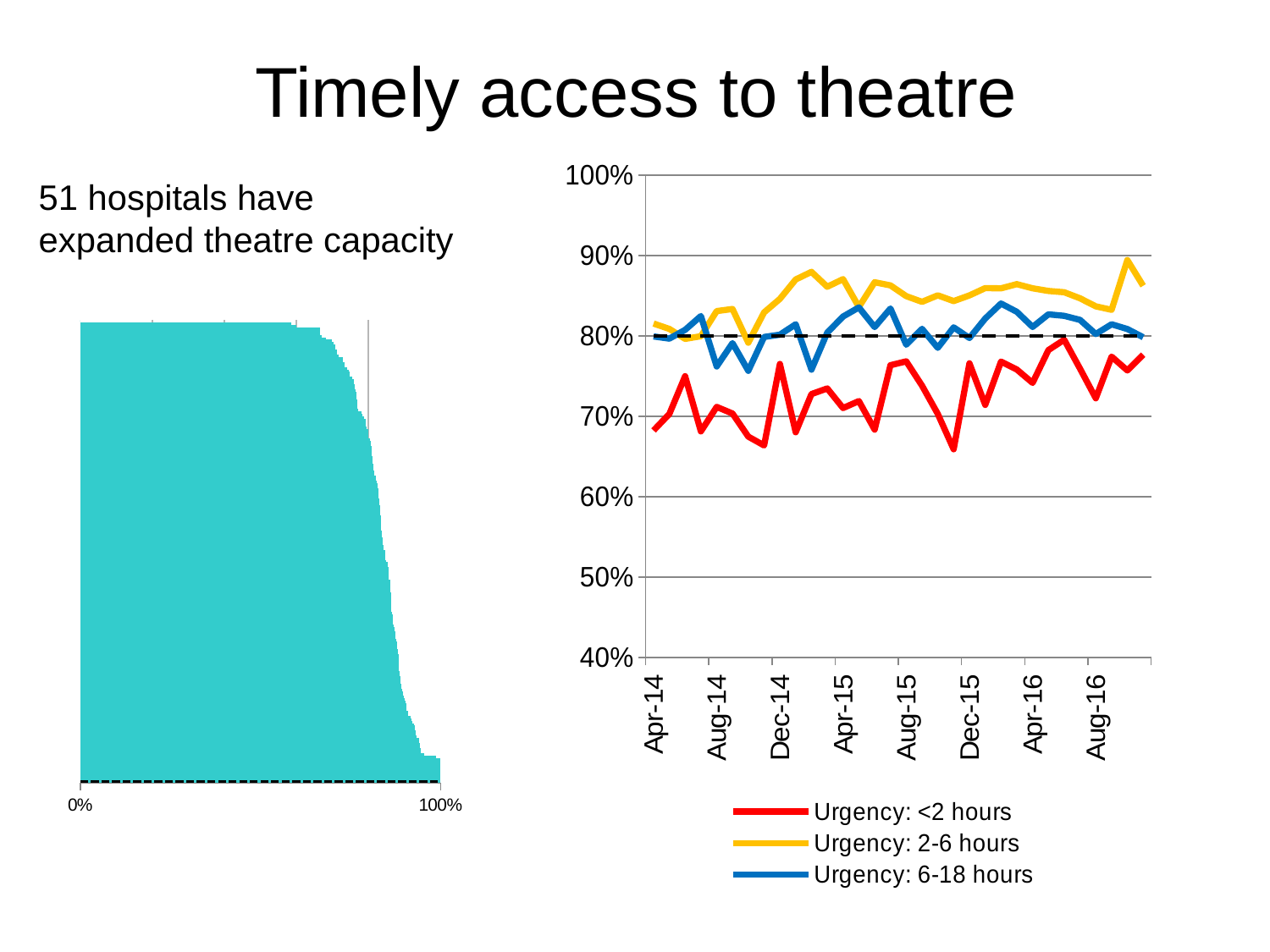
On the right-hand chart, is the value for Urgency: 6-18 hours at Apr-15 greater or less than 70%? greater On the right-hand chart, how many series does the legend list? 3 On the right-hand chart, what is the lowest value shown on the y axis? 40% On the right-hand chart, how many date labels are shown on the x axis? 8 On the right-hand chart, is the value for Urgency: <2 hours at Dec-15 greater or less than 70%? greater On the right-hand chart, is the value for Urgency: <2 hours at Apr-16 greater or less than 80%? less On the right-hand chart, which is larger at Aug-16: Urgency: 2-6 hours or Urgency: <2 hours? Urgency: 2-6 hours On the right-hand chart, what colour is the line for Urgency: 6-18 hours? blue On the right-hand chart, which urgency series has the lowest values across the period? Urgency: <2 hours On the right-hand chart, which urgency series has the highest values across the period? Urgency: 2-6 hours What kind of chart is the right-hand chart with the urgency series? line chart